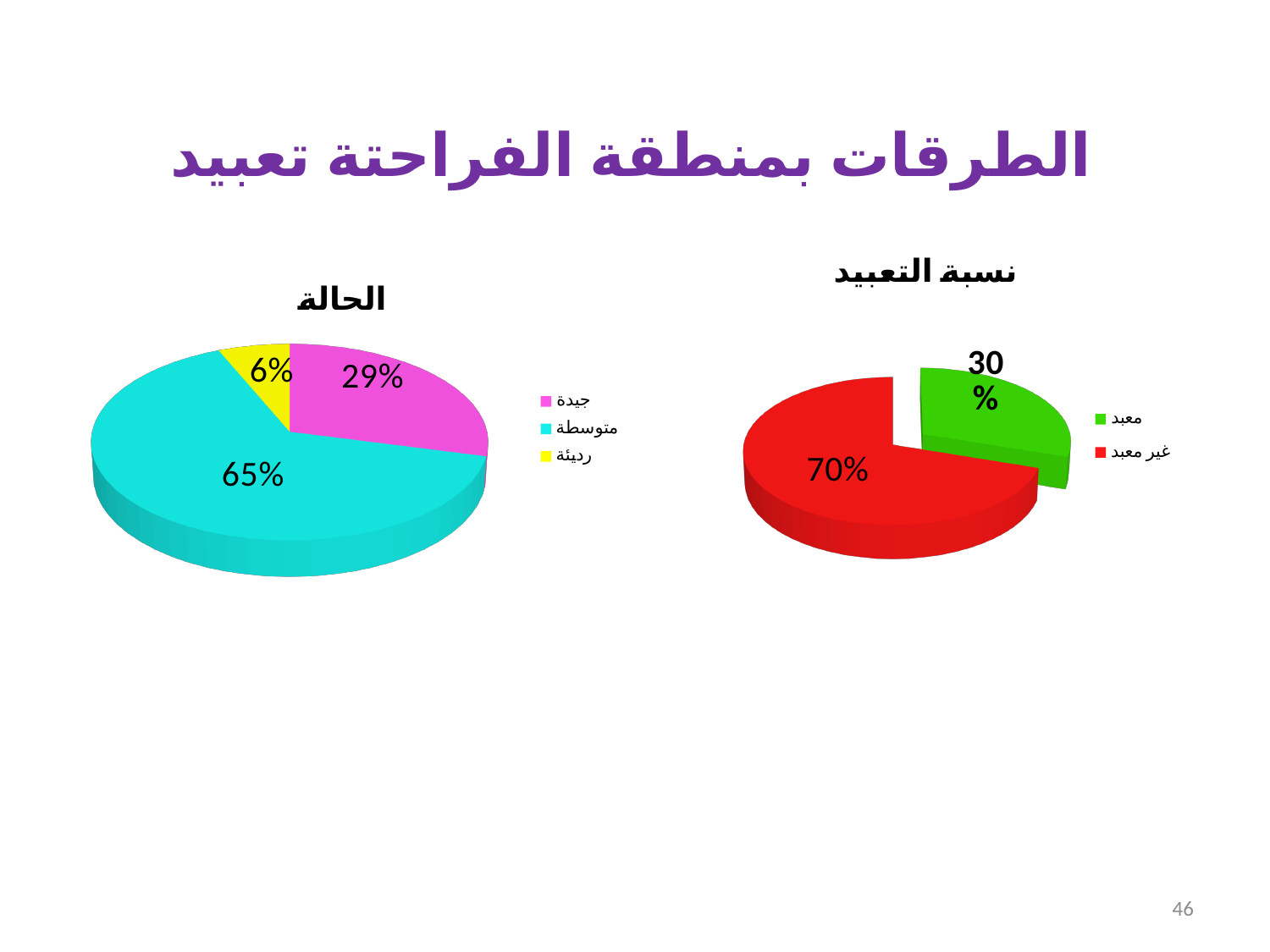
In the chart titled "الحالة", which category has the smallest slice? رديئة In the chart titled "الحالة", what percentage is shown for the "متوسطة" slice? 65% In the chart titled "نسبة التعبيد", which is larger, "معبد" or "غير معبد"? غير معبد In the chart titled "نسبة التعبيد", what percentage is shown for "غير معبد"? 70% In the chart titled "الحالة", which category has the largest slice? متوسطة In the chart titled "الحالة", what percentage is shown for the "جيدة" slice? 29% In the chart titled "الحالة", what is the difference between the "متوسطة" and "جيدة" percentages? 36% In the chart titled "الحالة", how many slices does the pie have? 3 In the chart titled "نسبة التعبيد", what colour is the "غير معبد" slice? Red In the chart titled "نسبة التعبيد", what percentage is shown for "معبد"? 30% In the chart titled "الحالة", what percentage is shown for the "رديئة" slice? 6% What type of chart is the chart titled "نسبة التعبيد"? Pie chart